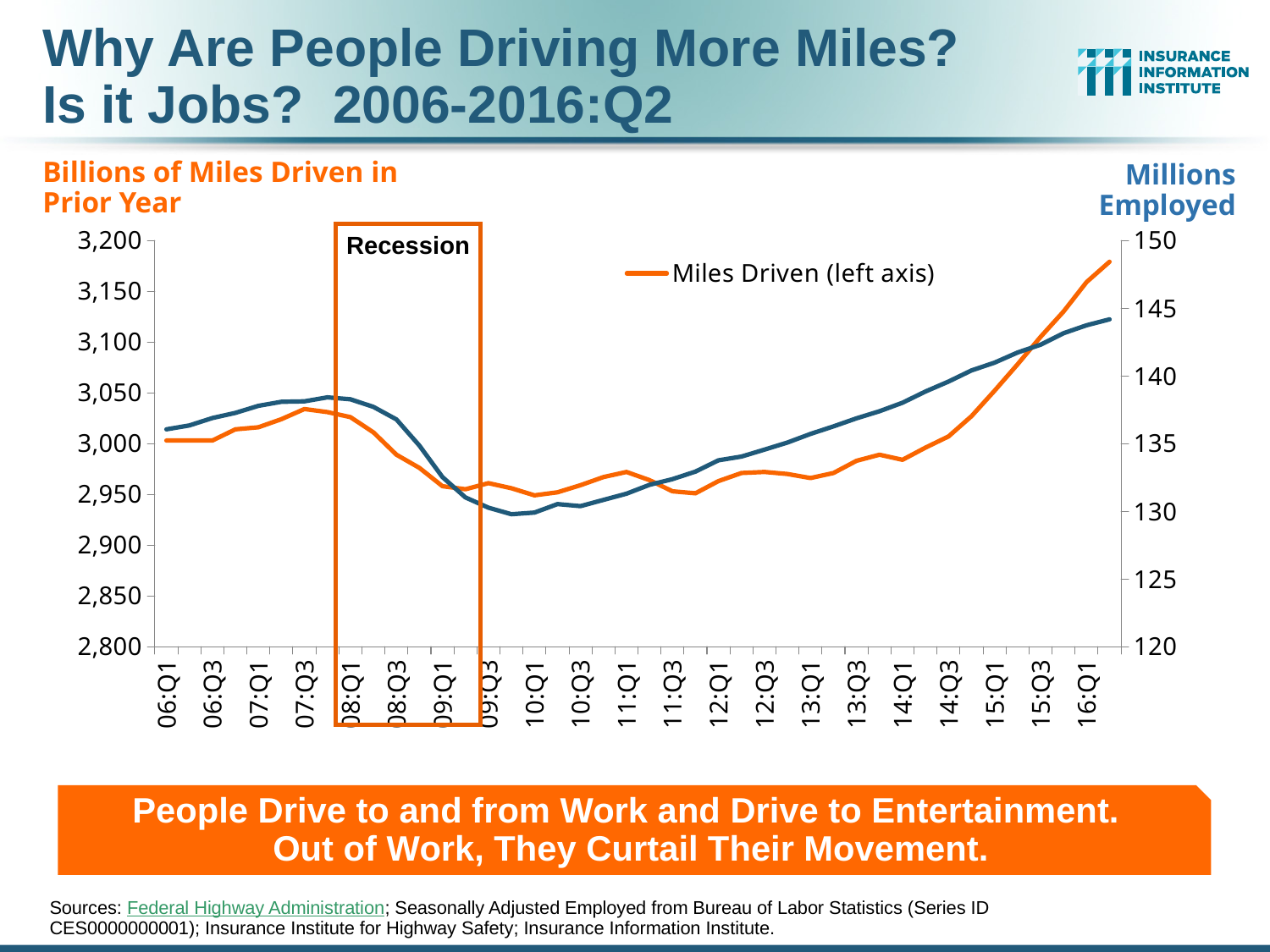
What kind of chart is shown on the slide? line chart Is the highest value of the Miles Driven line at the start or the end of the period shown? end Which is larger for Miles Driven: the value at 16:Q1 or the value at 06:Q1? 16:Q1 Does the Miles Driven line rise or fall between 07:Q3 and 09:Q1? fall Is the value for Miles Driven at 09:Q1 greater or less than 3,000? less What is the title of the right-hand axis? Millions Employed How many quarter labels are shown along the x axis? 21 Is the value for Miles Driven at 13:Q1 greater or less than 3,000? less Does the Miles Driven line rise or fall between 14:Q1 and 16:Q1? rise Is the value for Miles Driven at 16:Q1 greater or less than 3,150? greater How many series does the chart's legend list? 1